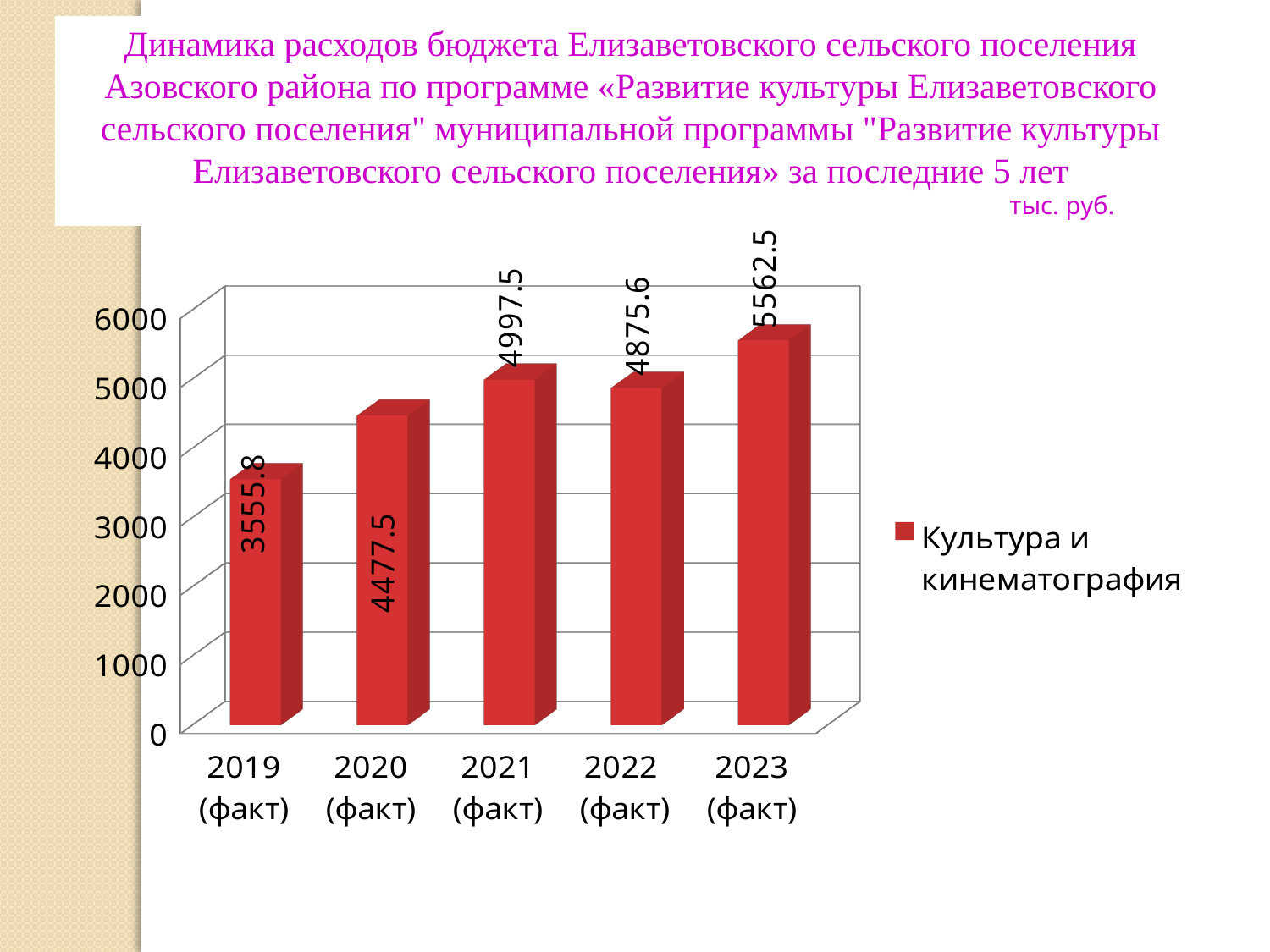
What kind of chart is shown on the slide? bar chart What series name does the legend show? Культура и кинематография Which year has the lowest value? 2019 (факт) What is the value for 2023 (факт)? 5562.5 Which year has the highest value? 2023 (факт) What is the difference between the values for 2023 (факт) and 2019 (факт)? 2006.7 What is the difference between the values for 2021 (факт) and 2022 (факт)? 121.9 Which is larger, the value for 2020 (факт) or the value for 2022 (факт)? 2022 (факт) Is the value for 2020 (факт) greater or less than 4000? greater How many years are shown on the x axis? 5 What is the value for 2021 (факт)? 4997.5 What is the value for 2019 (факт)? 3555.8